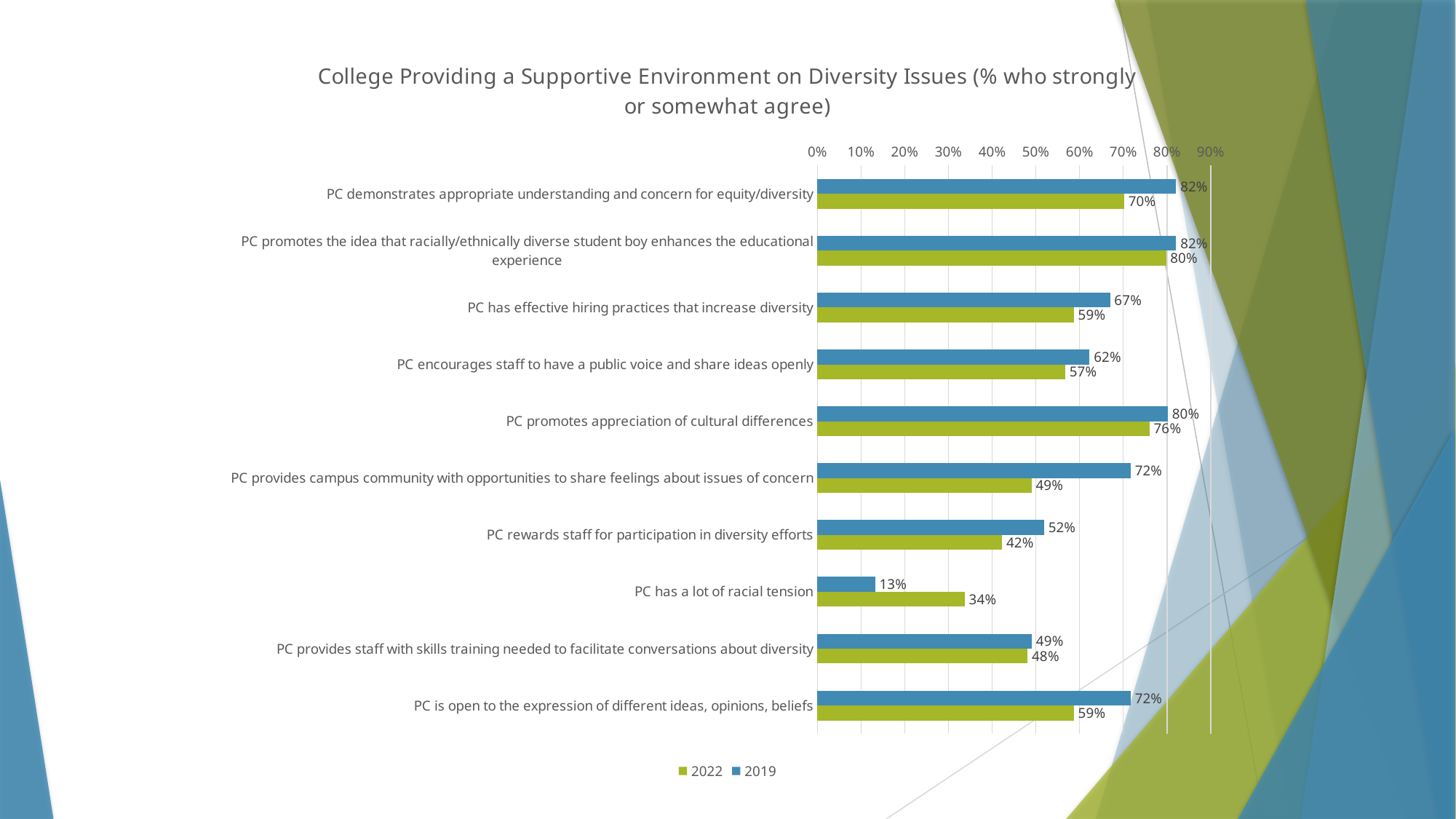
For "PC has a lot of racial tension", which year has the larger value, 2019 or 2022? 2022 What kind of chart is shown on the slide? Bar chart How many categories are shown on the chart? 10 What is the 2022 value for "PC has a lot of racial tension"? 34% What is the 2019 value for "PC demonstrates appropriate understanding and concern for equity/diversity"? 82% Which category has the lowest 2019 value? PC has a lot of racial tension What is the difference between the 2019 and 2022 values for "PC provides campus community with opportunities to share feelings about issues of concern"? 23% What is the 2019 value for "PC encourages staff to have a public voice and share ideas openly"? 62% How many series does the legend list? 2 Which colour represents the 2022 series in the legend? Green What is the 2022 value for "PC rewards staff for participation in diversity efforts"? 42% Which category has the highest 2022 value? PC promotes the idea that racially/ethnically diverse student boy enhances the educational experience